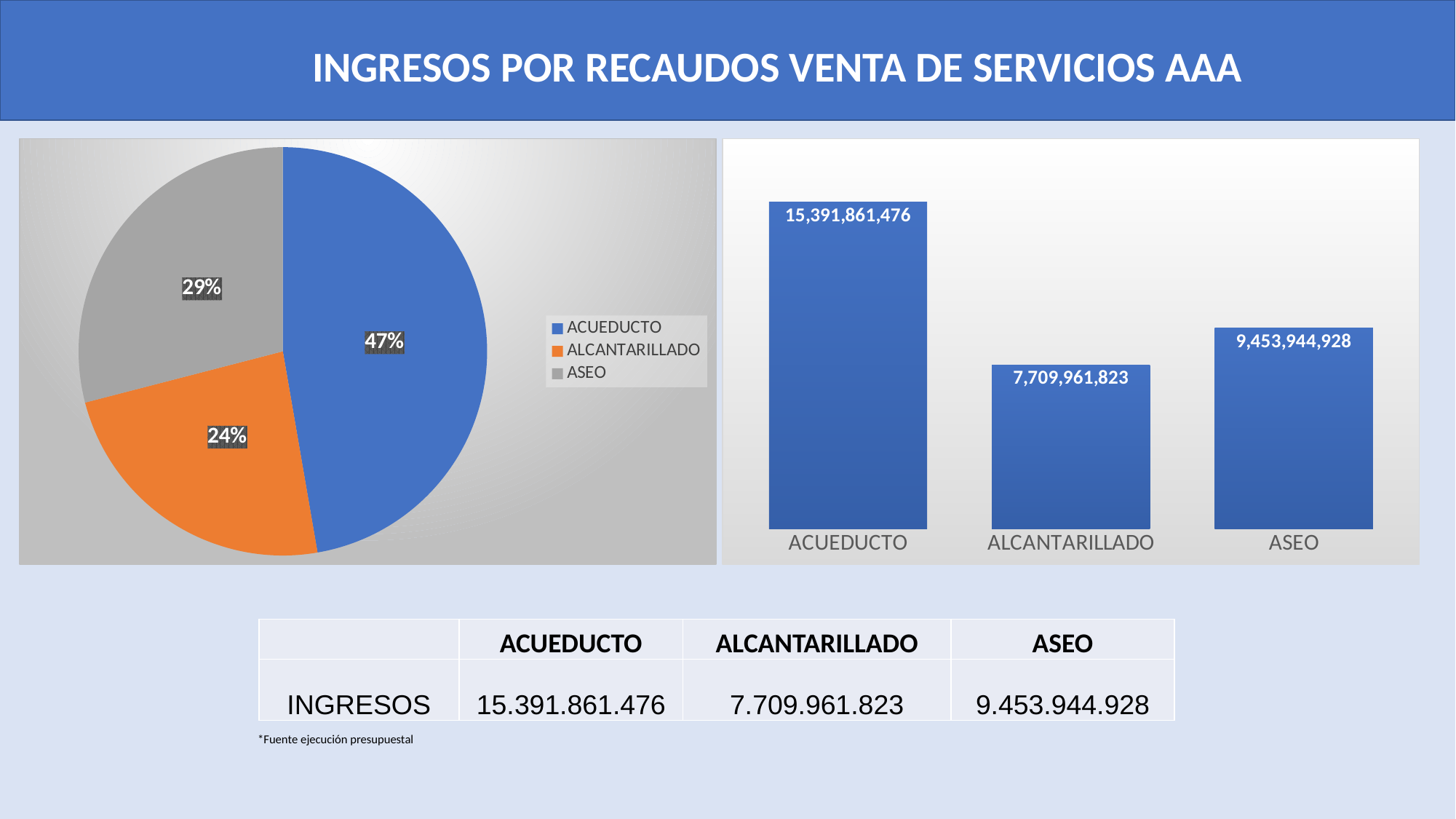
In the bar chart on the right, what is the difference between the values for ACUEDUCTO and ALCANTARILLADO? 7,681,899,653 In the bar chart on the right, what is the value for ACUEDUCTO? 15,391,861,476 In the bar chart on the right, which is larger, the value for ASEO or the value for ALCANTARILLADO? ASEO In the bar chart on the right, what is the value for ASEO? 9,453,944,928 In the pie chart on the left, which slice is the largest? ACUEDUCTO In the bar chart on the right, what is the value for ALCANTARILLADO? 7,709,961,823 In the bar chart on the right, which category has the highest value? ACUEDUCTO What kind of chart is on the left side of the slide? Pie chart In the bar chart on the right, which category has the lowest value? ALCANTARILLADO In the bar chart on the right, what is the difference between the values for ASEO and ALCANTARILLADO? 1,743,983,105 How many bars are in the bar chart on the right? 3 In the pie chart on the left, what share does ALCANTARILLADO have? 24%